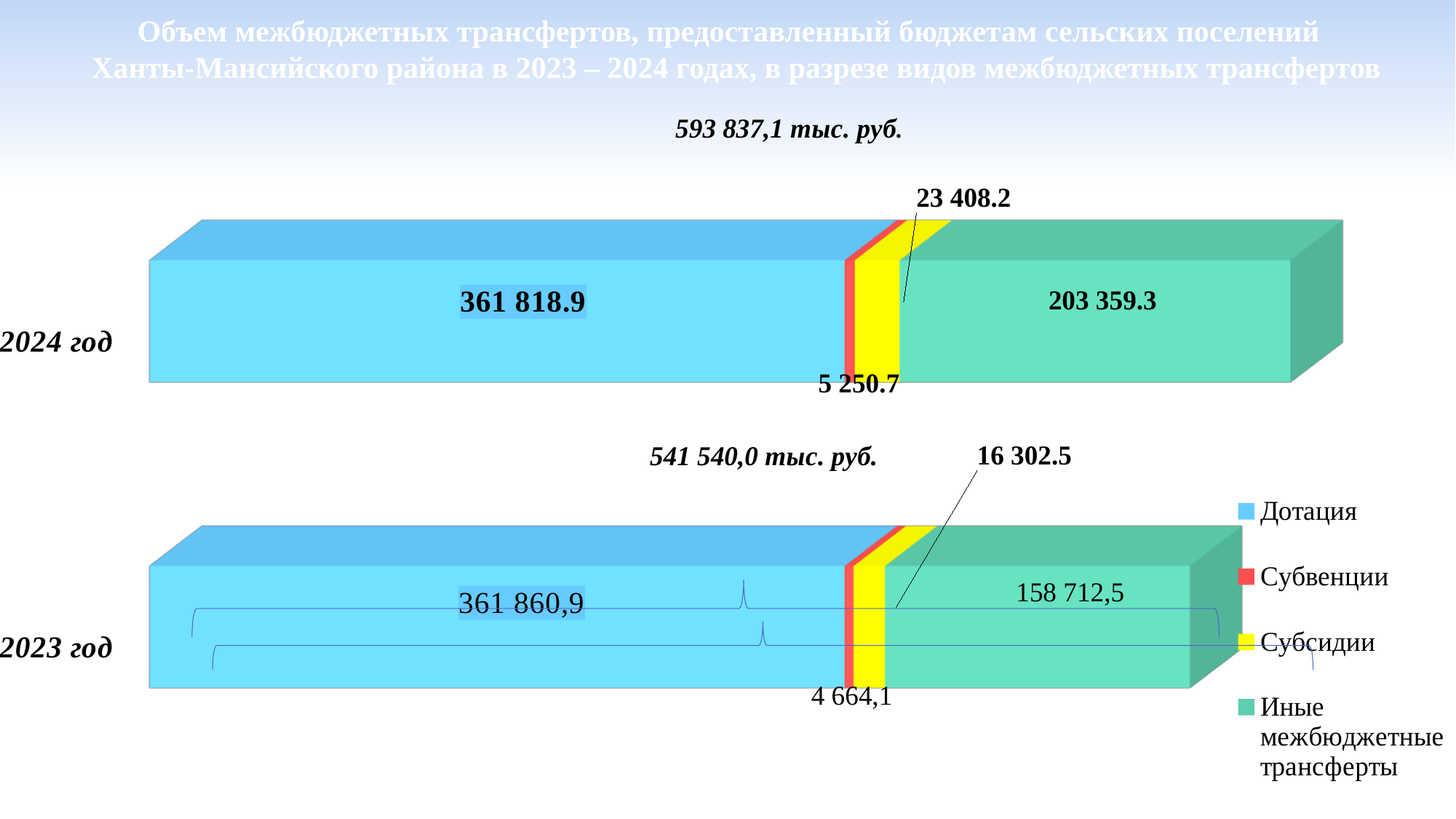
What is the value of Иные межбюджетные трансферты for 2024 год? 203 359.3 What is the difference between Иные межбюджетные трансферты in 2024 год and 2023 год? 44 646.8 What is the total of the stacked bar for 2023 год? 541 540,0 тыс. руб. Which is larger: Субсидии in 2024 год or Субсидии in 2023 год? 2024 год Which series has the smallest value in the 2024 год bar? Субвенции How many series does the legend list? 4 What is the value of Субсидии for 2023 год? 16 302.5 What is the value of Дотация for 2024 год? 361 818.9 What is the value of Субвенции for 2023 год? 4 664,1 What is the total of the stacked bar for 2024 год? 593 837,1 тыс. руб. How many years (bars) are shown in the chart? 2 What type of chart is shown on the slide? Stacked bar chart